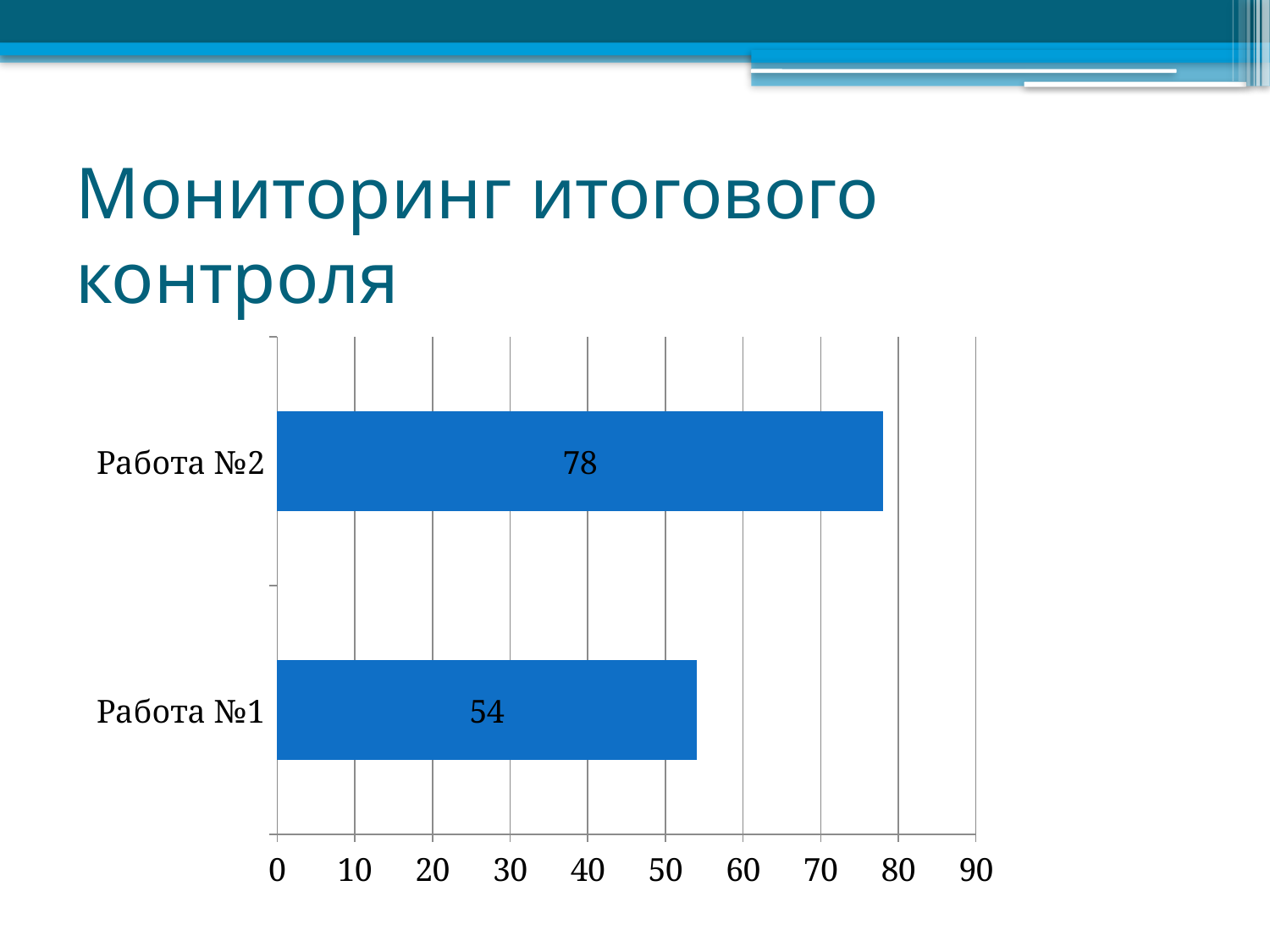
What is the maximum value shown on the horizontal axis? 90 How many categories are shown in the chart? 2 What is the difference between the values for Работа №2 and Работа №1? 24 Which is larger, the value for Работа №1 or the value for Работа №2? Работа №2 Which category has the highest value? Работа №2 Is the value for Работа №2 greater or less than 70? greater What is the value for Работа №2? 78 Which category has the lowest value? Работа №1 Is the value for Работа №1 greater or less than 60? less What is the value for Работа №1? 54 What kind of chart is shown on the slide? bar chart What is the title of the slide containing the chart? Мониторинг итогового контроля